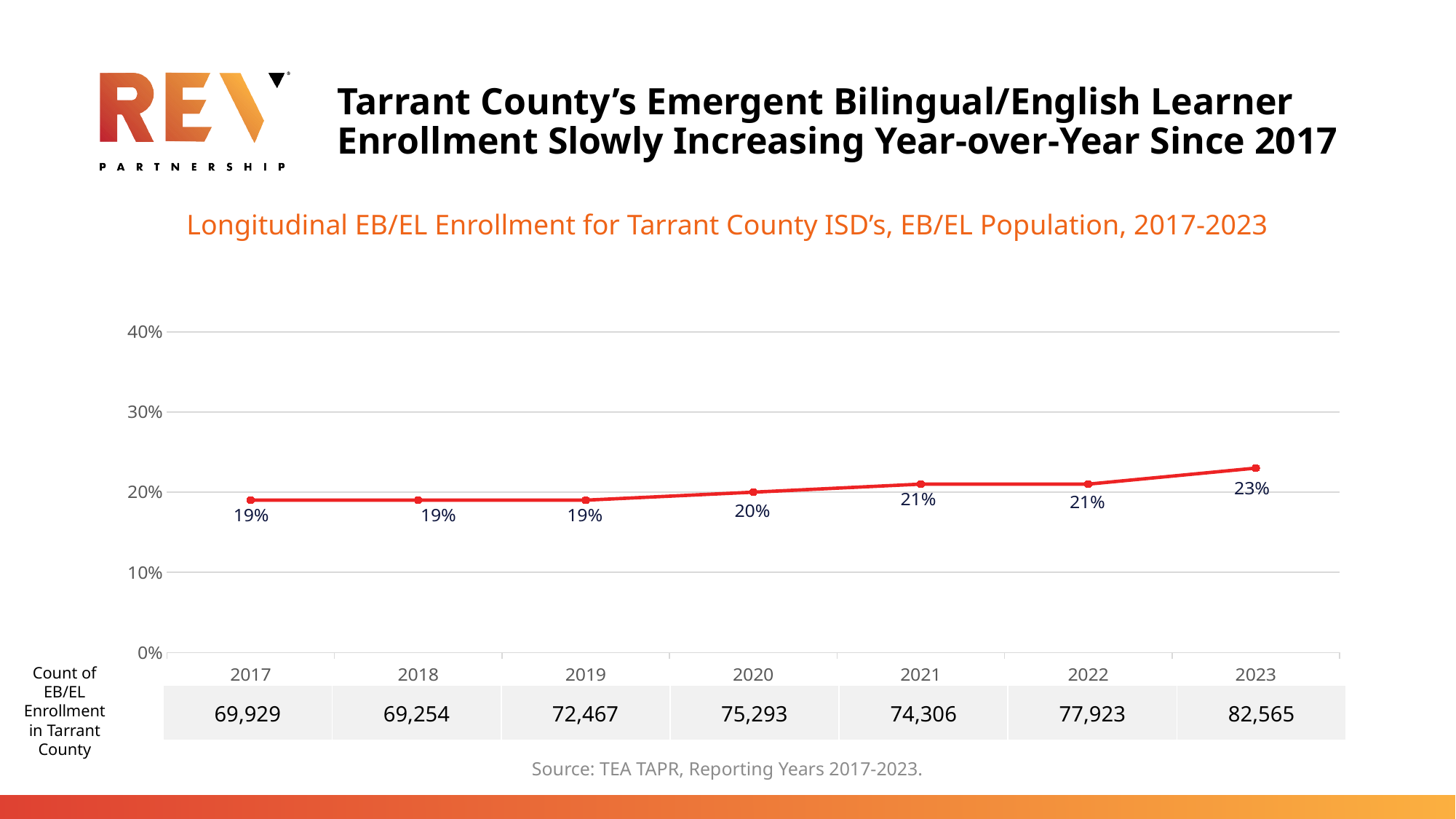
What is the difference in the count of EB/EL enrollment between 2023 and 2022? 4,642 What is the difference in EB/EL enrollment percentage between 2023 and 2017? 4% Which year has the highest EB/EL enrollment percentage? 2023 How many years are plotted on the chart? 7 Which year has a larger count of EB/EL enrollment, 2020 or 2021? 2020 Does the EB/EL enrollment percentage generally rise or fall from 2017 to 2023? rise What type of chart is shown on the slide? line chart What is the EB/EL enrollment percentage for 2020? 20% What is the EB/EL enrollment percentage for 2023? 23% What is the count of EB/EL enrollment in Tarrant County for 2019? 72,467 Which year has the lowest count of EB/EL enrollment in Tarrant County? 2018 What is the count of EB/EL enrollment in Tarrant County for 2022? 77,923